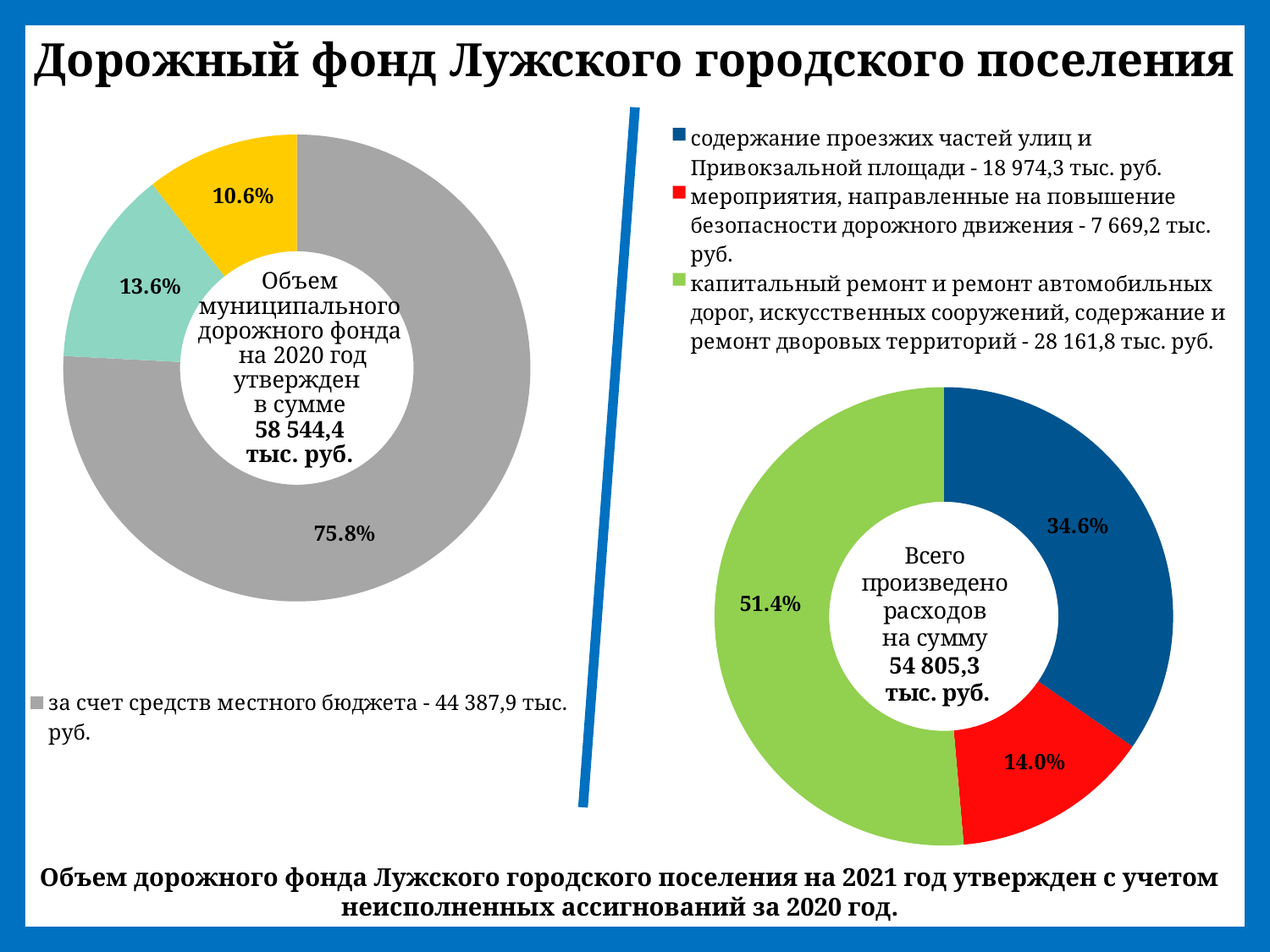
In the left chart, what percentage is shown for the teal slice? 13.6% What type of chart is shown on the left side of the slide? doughnut chart In the right chart, what share of expenditures went to maintenance of street carriageways and the station square (содержание проезжих частей улиц и Привокзальной площади)? 34.6% In the right chart, what is the difference in percentage points between the capital repair share and the road safety measures share? 37.4 In the right chart, how many entries does the legend list? 3 In the left chart, how many slices does the doughnut have? 3 In the right chart, what share of expenditures went to capital repair and repair of roads, engineering structures and courtyard areas (капитальный ремонт и ремонт автомобильных дорог)? 51.4% In the right chart, what share of expenditures went to road safety measures (мероприятия, направленные на повышение безопасности дорожного движения)? 14.0% In the left chart, what is the total volume of the municipal road fund approved for 2020, as stated in the centre? 58 544,4 тыс. руб. In the right chart, which expenditure category has the largest share? капитальный ремонт и ремонт автомобильных дорог, искусственных сооружений, содержание и ремонт дворовых территорий In the left chart, what percentage is shown for the yellow slice? 10.6% In the left chart, what share of the municipal road fund comes from local budget funds (за счет средств местного бюджета)? 75.8%